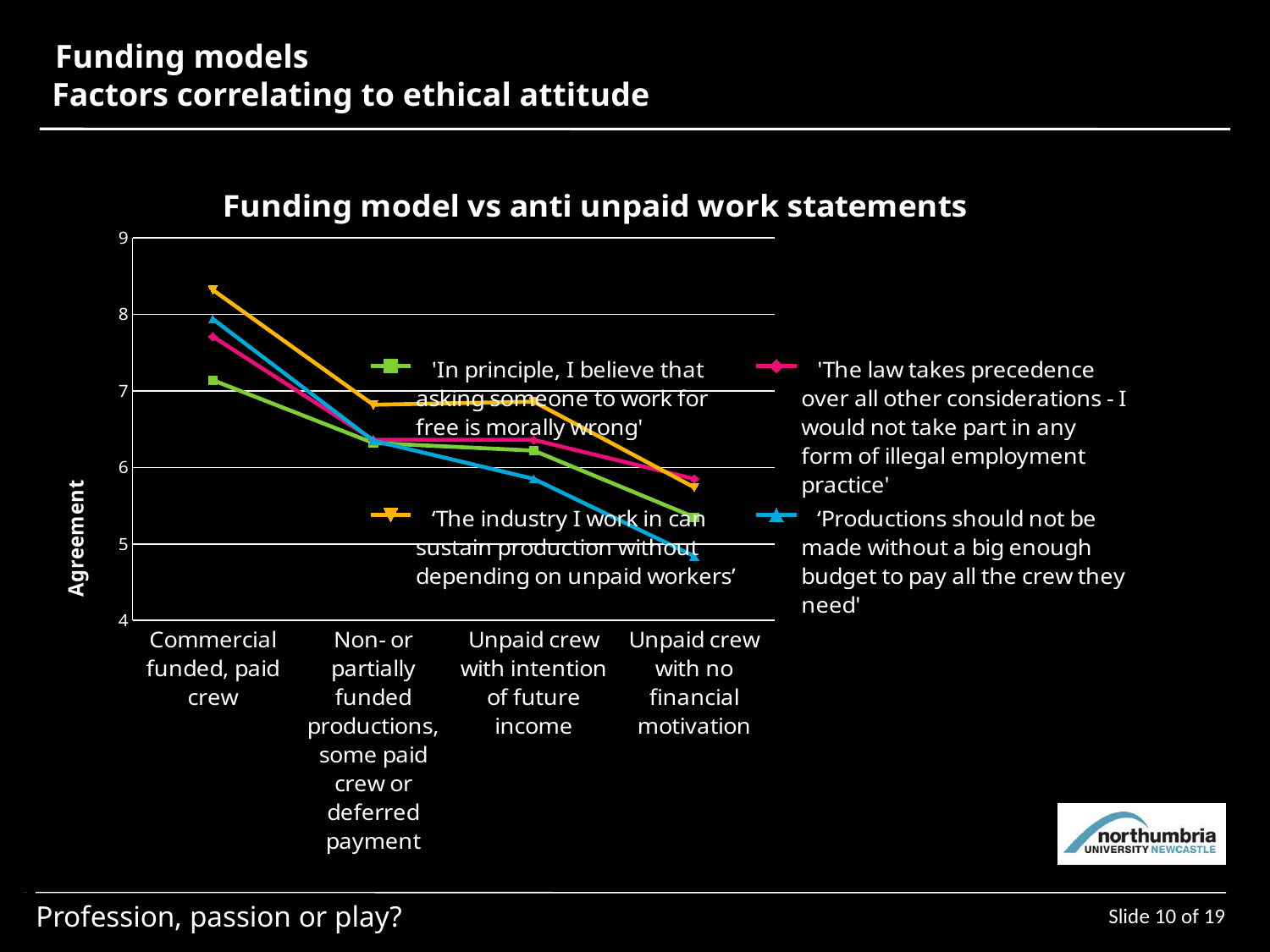
What is the title of the chart? Funding model vs anti unpaid work statements Which statement has the lowest agreement for 'Unpaid crew with no financial motivation'? 'Productions should not be made without a big enough budget to pay all the crew they need' What type of chart is shown on the slide? line chart At 'Commercial funded, paid crew', which has higher agreement: 'The industry I work in can sustain production without depending on unpaid workers' or 'In principle, I believe that asking someone to work for free is morally wrong'? 'The industry I work in can sustain production without depending on unpaid workers' Is the agreement for 'The industry I work in can sustain production without depending on unpaid workers' at 'Commercial funded, paid crew' greater or less than 8? greater What is the label on the vertical axis? Agreement How many funding model categories are shown on the x axis? 4 Is the agreement for 'The industry I work in can sustain production without depending on unpaid workers' at 'Non- or partially funded productions, some paid crew or deferred payment' greater or less than 7? less Is the agreement for 'Productions should not be made without a big enough budget to pay all the crew they need' at 'Unpaid crew with no financial motivation' greater or less than 5? less Does agreement with 'Productions should not be made without a big enough budget to pay all the crew they need' rise or fall from 'Commercial funded, paid crew' to 'Unpaid crew with no financial motivation'? fall How many series does the legend list? 4 Which statement has the highest agreement for 'Commercial funded, paid crew'? 'The industry I work in can sustain production without depending on unpaid workers'